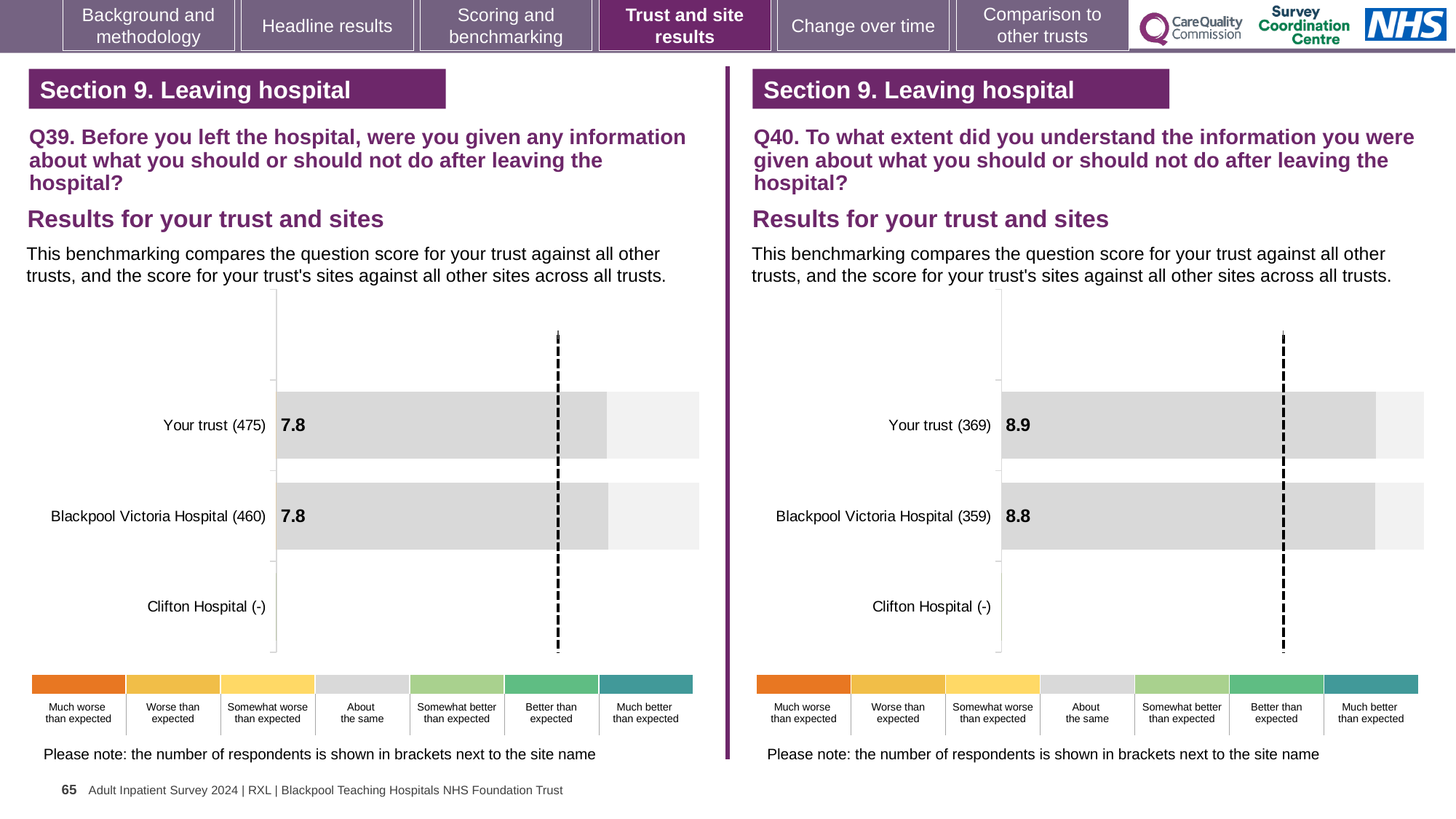
In the Q39 chart on the left, how many categories (rows) are listed on the vertical axis? 3 In the Q40 chart on the right, how many benchmark bands are shown in the colour key below the chart? 7 In the Q40 chart on the right, how many respondents are shown in brackets for Blackpool Victoria Hospital? 359 In the Q40 chart on the right, what is the score for Your trust? 8.9 What kind of chart is used in the Q40 chart on the right? Bar chart In the Q39 chart on the left, what is the score for Your trust? 7.8 In the Q39 chart on the left, how many respondents are shown in brackets for Your trust? 475 In the Q40 chart on the right, what is the difference between the score for Your trust and the score for Blackpool Victoria Hospital? 0.1 In the Q39 chart on the left, which category has no score shown? Clifton Hospital In the Q40 chart on the right, what is the score for Blackpool Victoria Hospital? 8.8 In the Q39 chart on the left, what is the score for Blackpool Victoria Hospital? 7.8 In the Q39 chart on the left, is the score for Your trust the same as the score for Blackpool Victoria Hospital? Yes